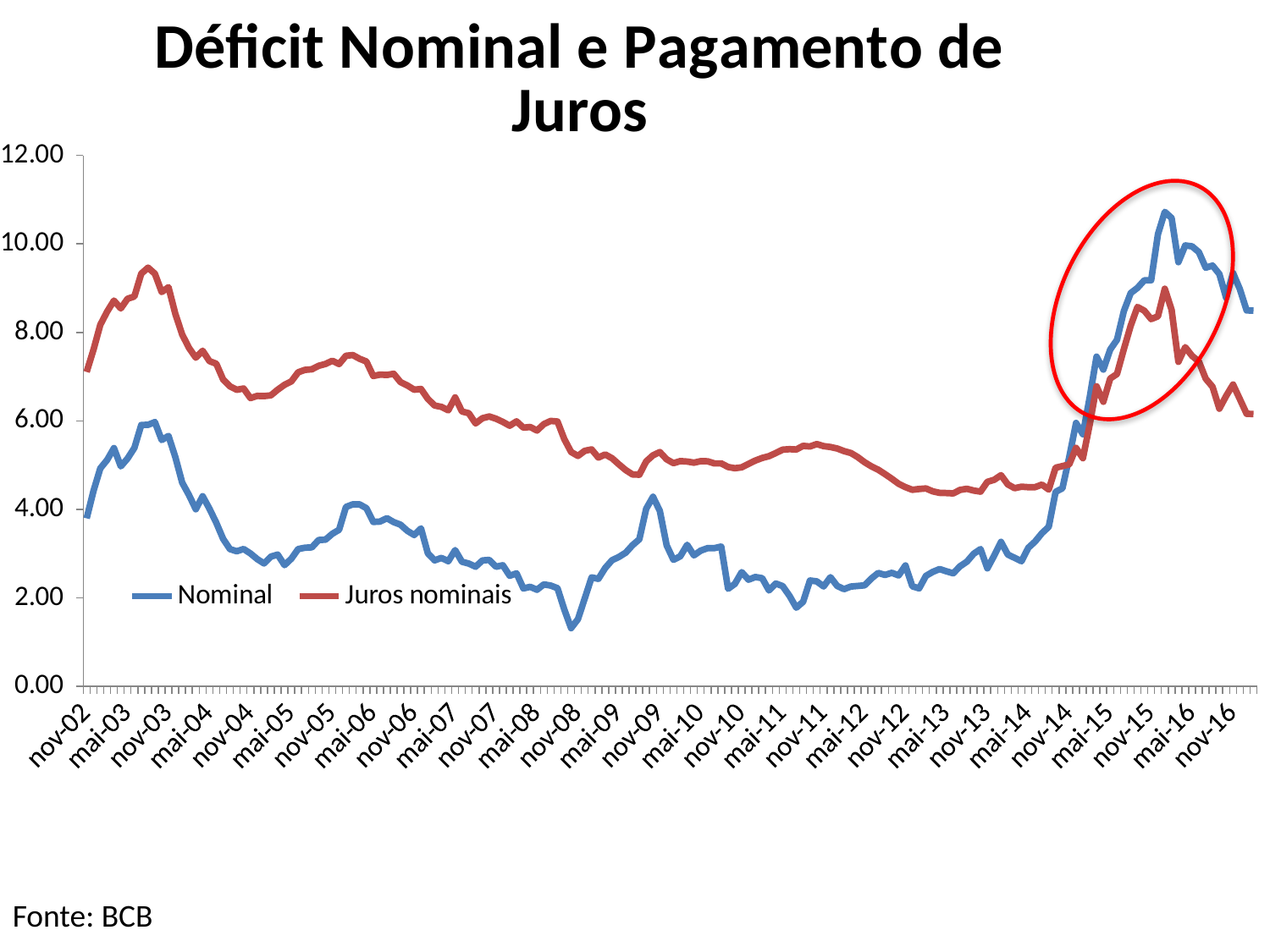
Is the value of Nominal at nov-08 greater or less than 2.00? less Is the peak value of the Nominal series around nov-15 greater or less than 10.00? greater Is the value of Juros nominais at nov-02 greater or less than 6.00? greater Does the Nominal series rise or fall between mai-14 and nov-15? rise At nov-15, which series has the higher value, Nominal or Juros nominais? Nominal What is the title of the chart? Déficit Nominal e Pagamento de Juros Which series is drawn in red? Juros nominais Which series reaches the highest value anywhere on the chart? Nominal At nov-02, which series has the higher value, Nominal or Juros nominais? Juros nominais What kind of chart is shown on the slide? Line chart How many series does the legend list? 2